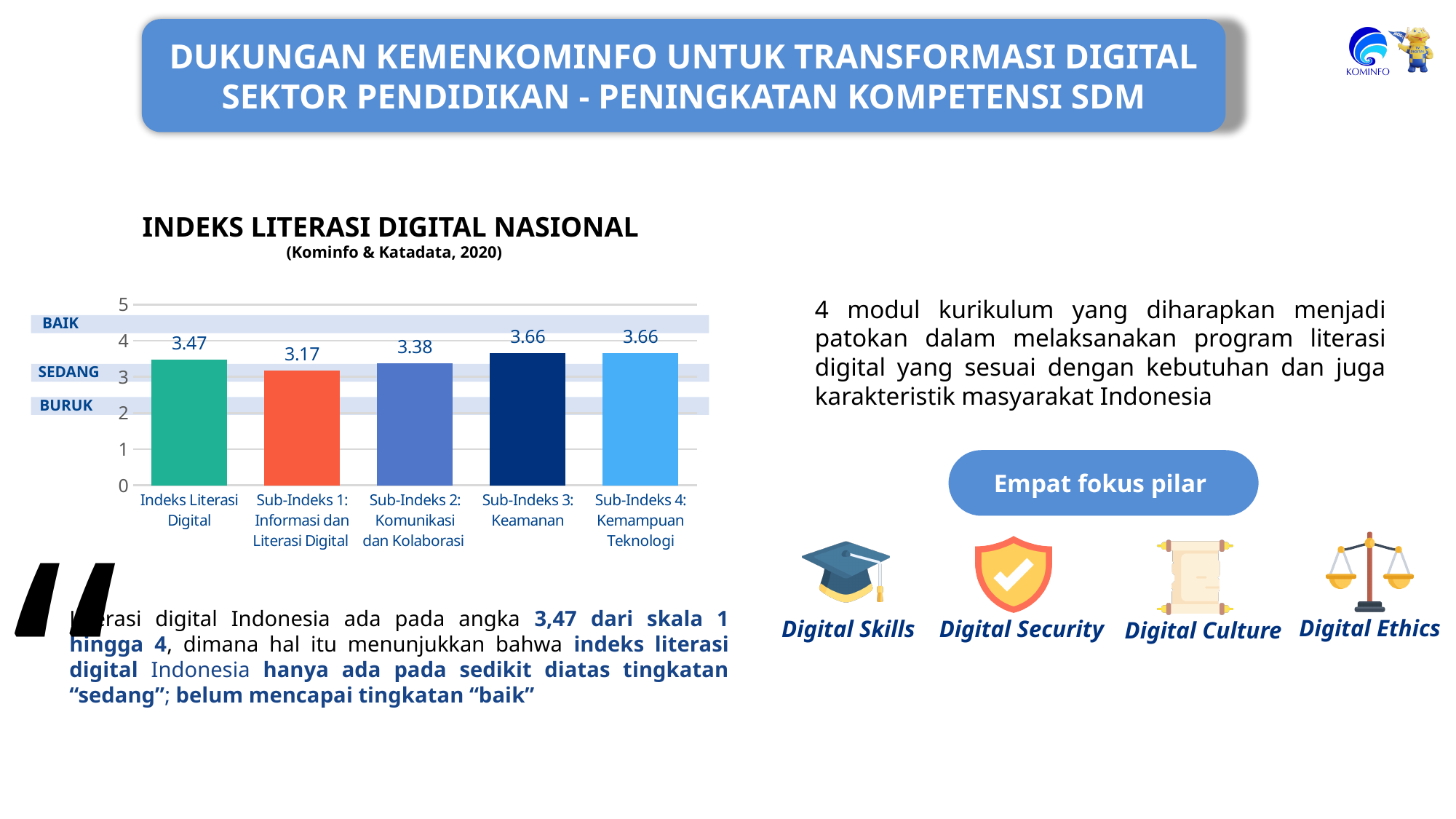
What is the value for Sub-Indeks 1: Informasi dan Literasi Digital? 3.17 Is the value for Sub-Indeks 4: Kemampuan Teknologi greater or less than 4? less Which category has the lowest value? Sub-Indeks 1: Informasi dan Literasi Digital What is the source cited under the chart title? Kominfo & Katadata, 2020 What is the value for Sub-Indeks 2: Komunikasi dan Kolaborasi? 3.38 What is the value for Indeks Literasi Digital? 3.47 What is the difference between the values for Sub-Indeks 3: Keamanan and Sub-Indeks 1: Informasi dan Literasi Digital? 0.49 What is the value for Sub-Indeks 3: Keamanan? 3.66 What is the title of the chart? INDEKS LITERASI DIGITAL NASIONAL What kind of chart is shown on the slide? bar chart How many categories are shown in the chart? 5 Which is larger, the value for Indeks Literasi Digital or the value for Sub-Indeks 2: Komunikasi dan Kolaborasi? Indeks Literasi Digital